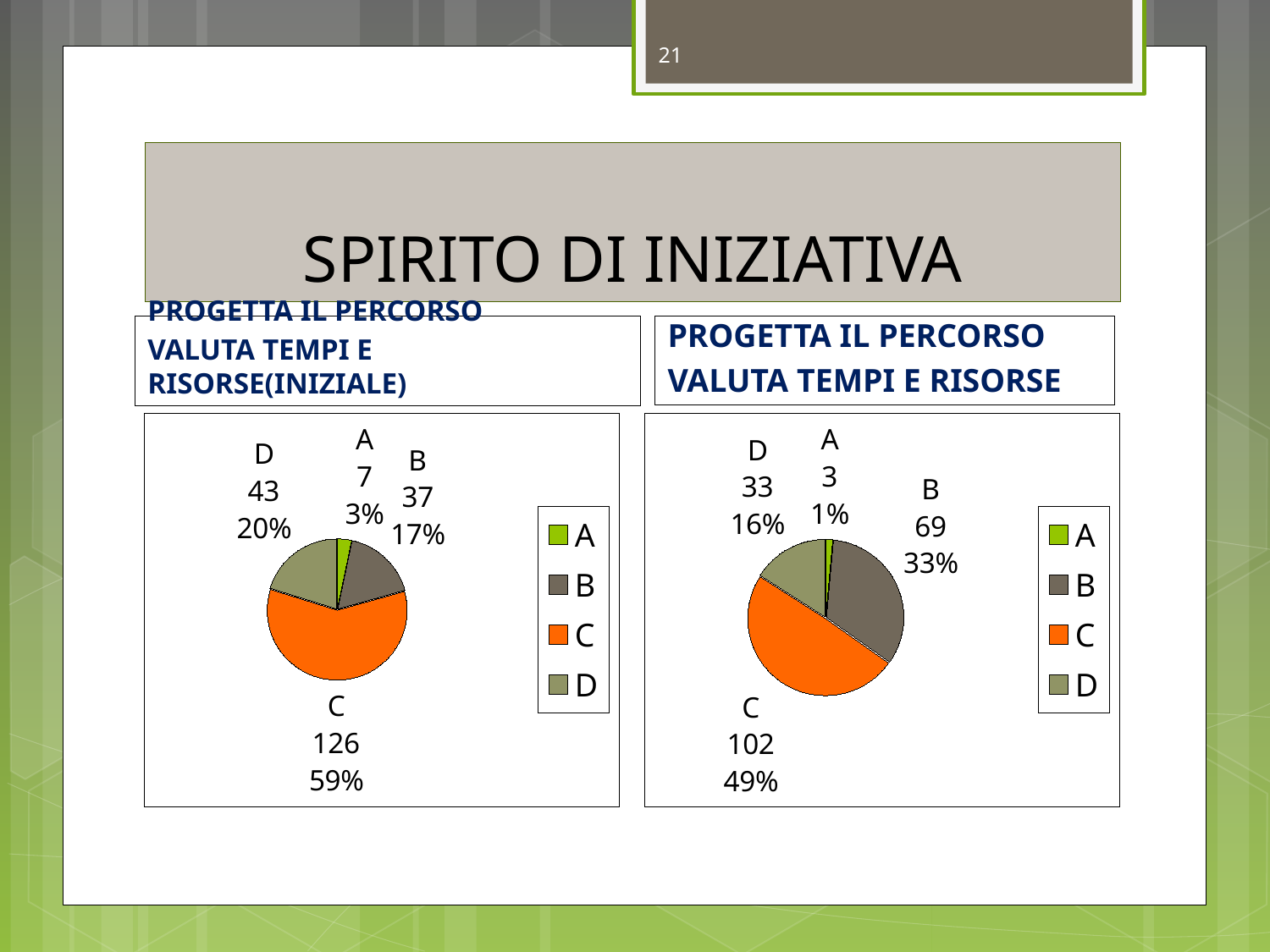
What type of chart is used on the right side of the slide? Pie chart In the right pie chart, which category has the smallest slice? A In the right pie chart, what percentage share does category C have? 49% In the right pie chart, which is larger, the value for B or the value for D? B In the right pie chart (PROGETTA IL PERCORSO VALUTA TEMPI E RISORSE), what is the value for category B? 69 In the left pie chart (INIZIALE), what colour represents category C in the legend? Orange In the left pie chart (INIZIALE), what is the value for category C? 126 In the right pie chart, what is the difference between the values for B and D? 36 In the left pie chart (INIZIALE), which category has the largest slice? C In the left pie chart (INIZIALE), what is the difference between the values for C and B? 89 How many categories does the left pie chart (INIZIALE) show? 4 In the left pie chart (INIZIALE), what percentage share does category D have? 20%